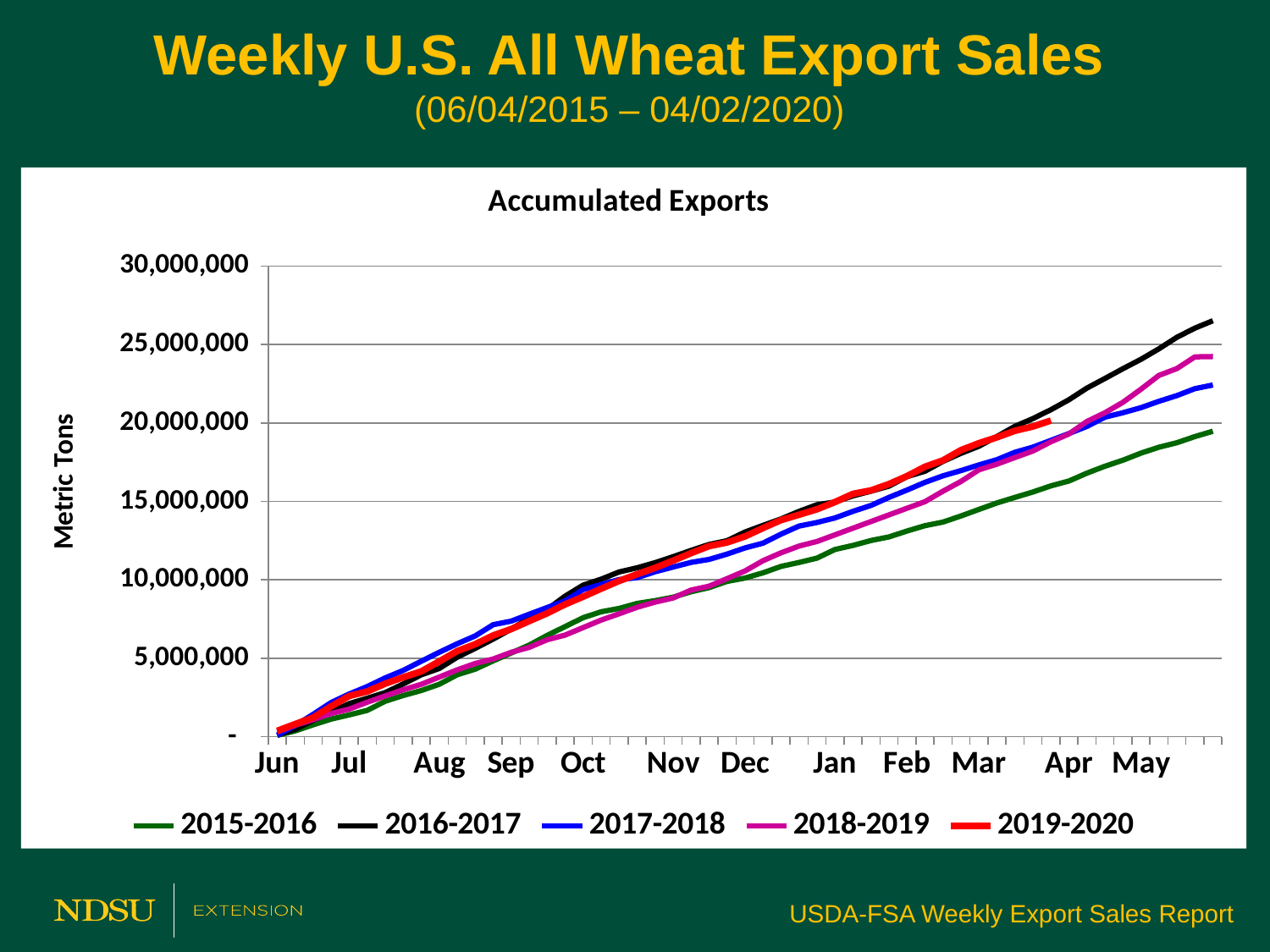
What kind of chart is shown on the slide? line chart At Dec, which series is higher: 2016-2017 or 2015-2016? 2016-2017 Do the accumulated export values rise or fall from Jun to May? rise Which series has the lowest accumulated exports by the end of May? 2015-2016 How many month labels are shown on the x axis? 12 Is the value for 2018-2019 at the end of May greater or less than 25,000,000? less Is the value for 2015-2016 at the end of May greater or less than 20,000,000? less Which series reaches the highest accumulated exports by the end of May? 2016-2017 How many series does the legend list? 5 What is the label on the y axis? Metric Tons Is the value for 2019-2020 at Feb greater or less than 15,000,000? greater